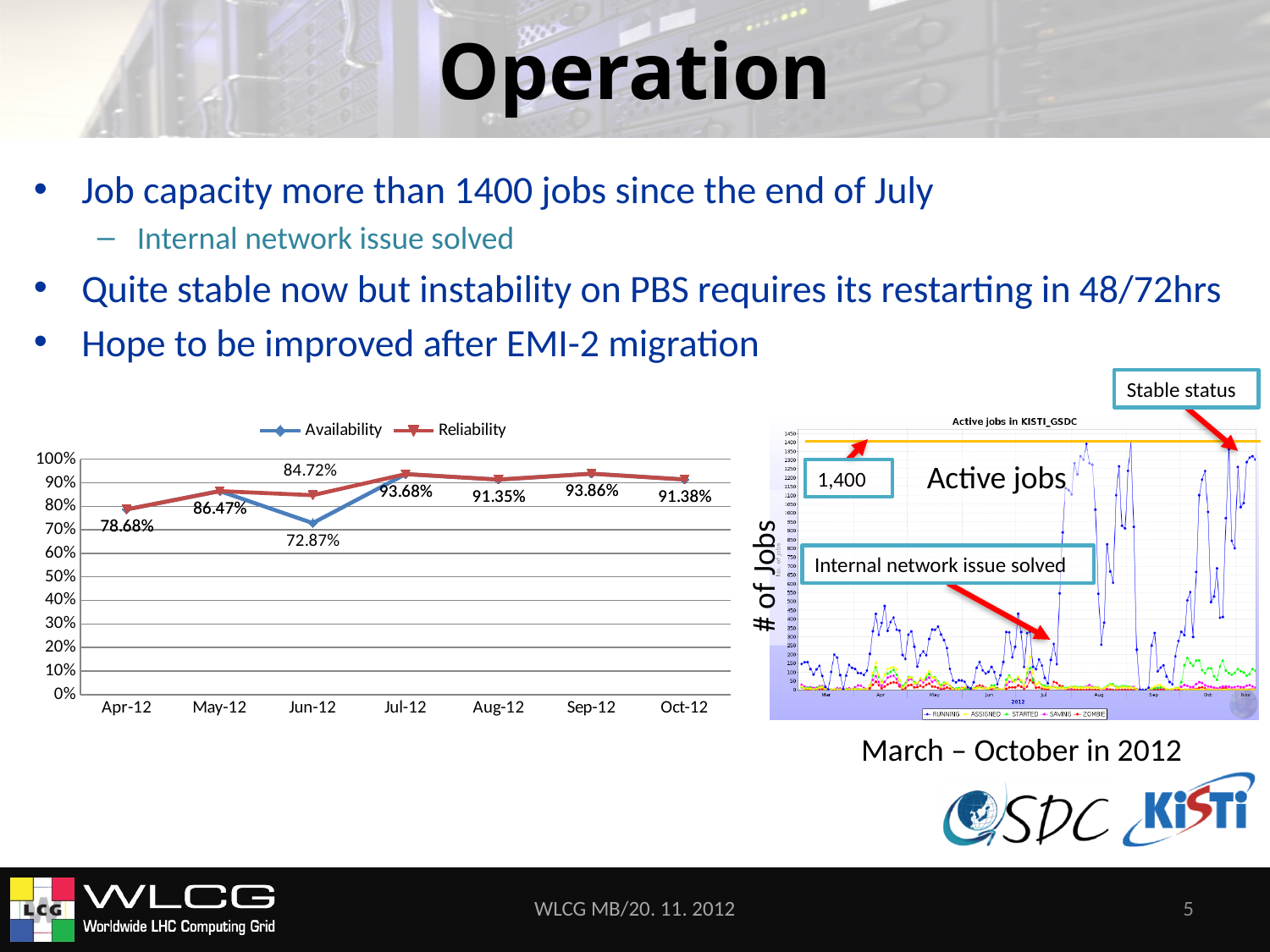
In the left chart, which month has the lowest labelled value? Jun-12 How many series does the legend of the left chart list? 2 In the left chart, is the Availability value for Jun-12 greater or less than 80%? less How many months are shown on the x axis of the left chart? 7 What is the title of the right chart? Active jobs in KISTI_GSDC In the left chart, what is the Reliability value for Jun-12? 84.72% In the left chart, what is the Availability value for Jun-12? 72.87% In the left chart, what is the difference between Reliability and Availability in Jun-12? 11.85 percentage points In the left chart, which month has the highest labelled value? Sep-12 What kind of chart is the left chart? line chart In the left chart, what value is labelled for Sep-12? 93.86% In the left chart, what value is labelled for Apr-12? 78.68%